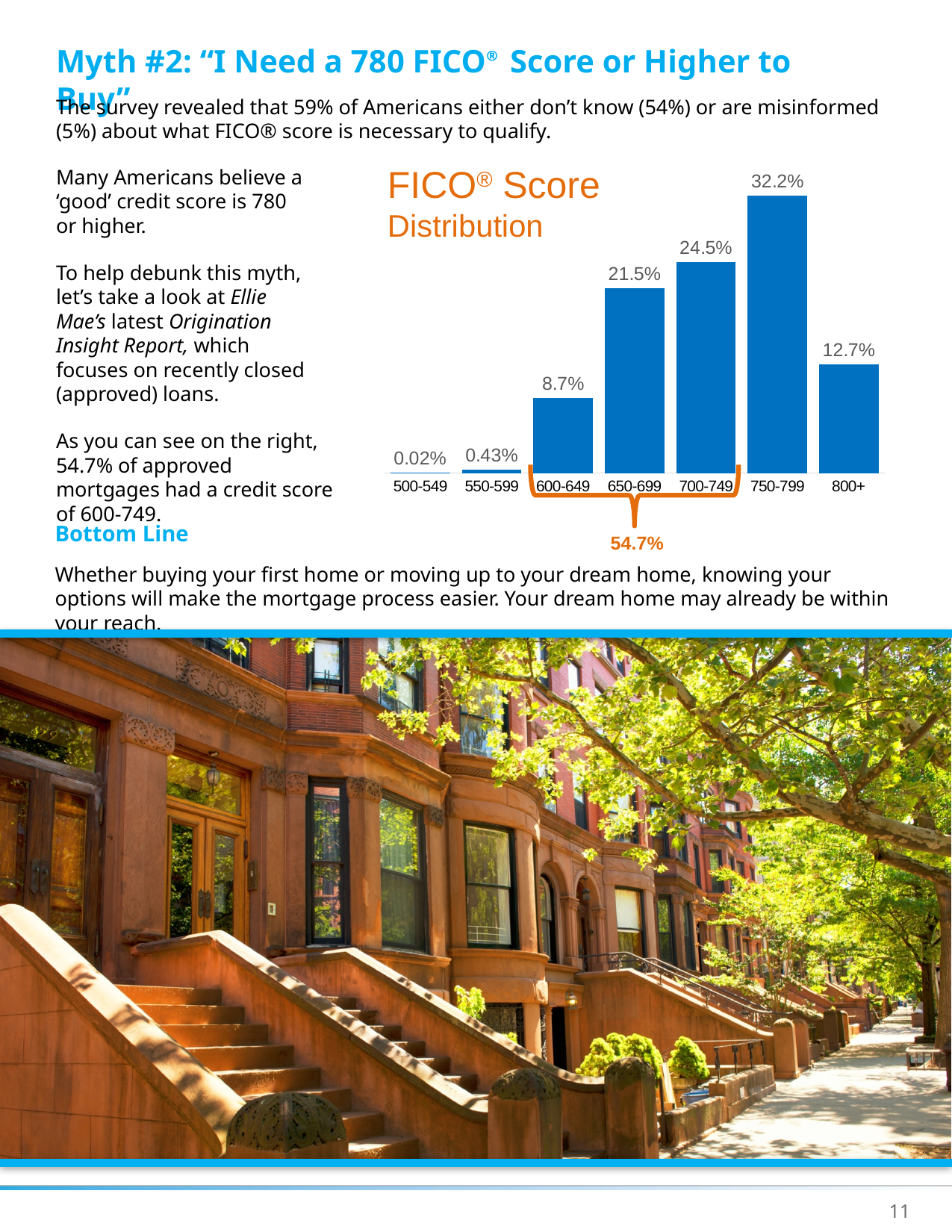
Which category has the highest value? 750-799 What is the combined total for the 600-649, 650-699 and 700-749 categories, as labelled by the bracket? 54.7% What is the title of the chart? FICO Score Distribution What is the difference between the values for 750-799 and 700-749? 7.7% Which is larger, the value for 650-699 or the value for 800+? 650-699 What is the value for the 600-649 category? 8.7% What is the value for the 800+ category? 12.7% How many categories are shown on the x axis? 7 Which category has the lowest value? 500-549 What is the value for the 750-799 category in the FICO Score Distribution chart? 32.2% What is the value for the 500-549 category? 0.02% What kind of chart is shown? Bar chart